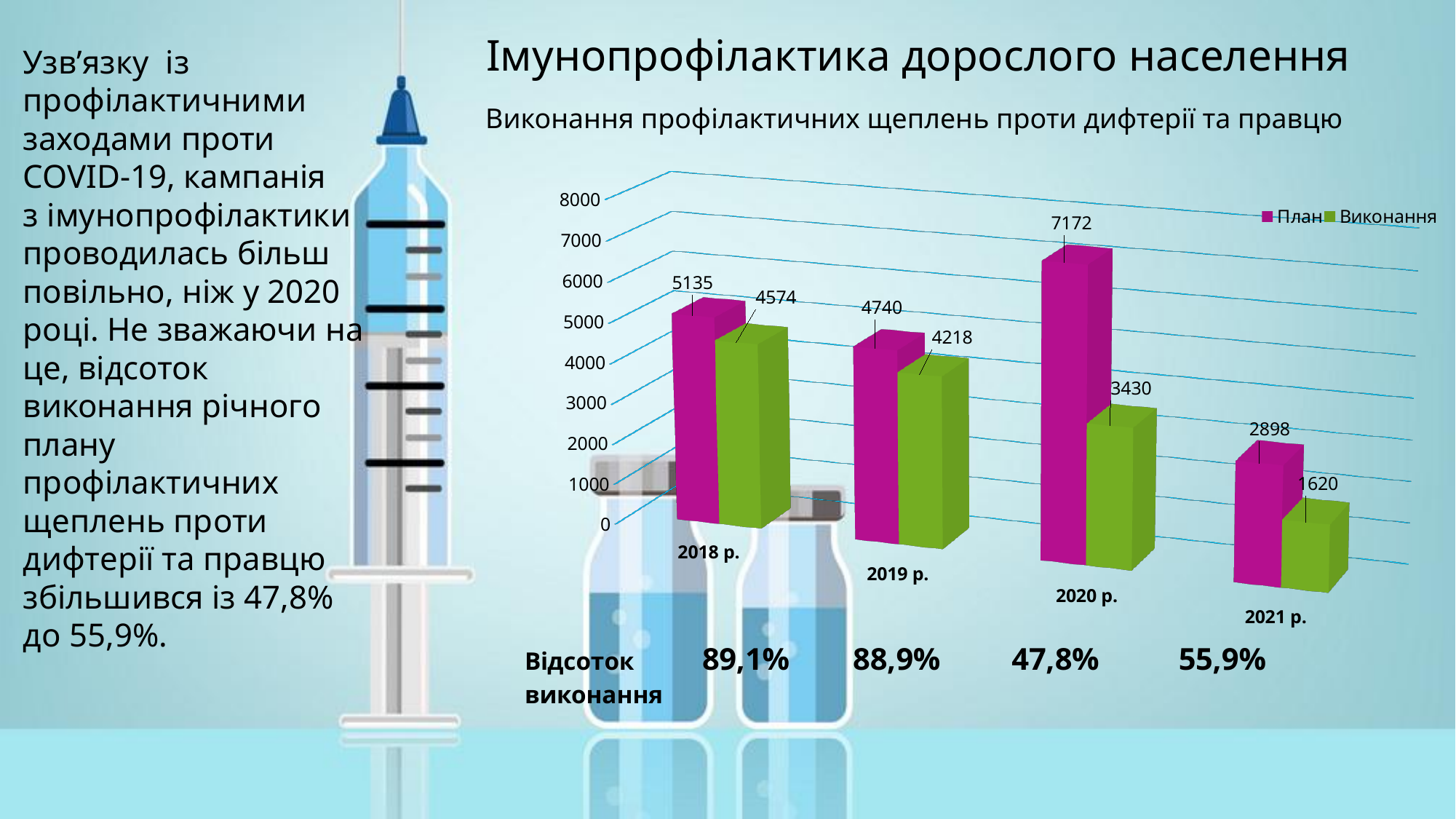
What is the value of Виконання for 2021 р.? 1620 Does the Виконання value rise or fall from 2018 р. to 2021 р.? fall What is the value of Виконання for 2020 р.? 3430 Which is larger: Виконання in 2018 р. or Виконання in 2019 р.? Виконання in 2018 р. Which year has the lowest Виконання value? 2021 р. What is the difference between План and Виконання in 2019 р.? 522 What kind of chart is shown on the slide? bar chart How many series does the legend list? 2 What is the value of План for 2018 р.? 5135 What is the difference between План and Виконання in 2020 р.? 3742 Which year has the highest План value? 2020 р. How many years are shown on the x axis of the chart? 4